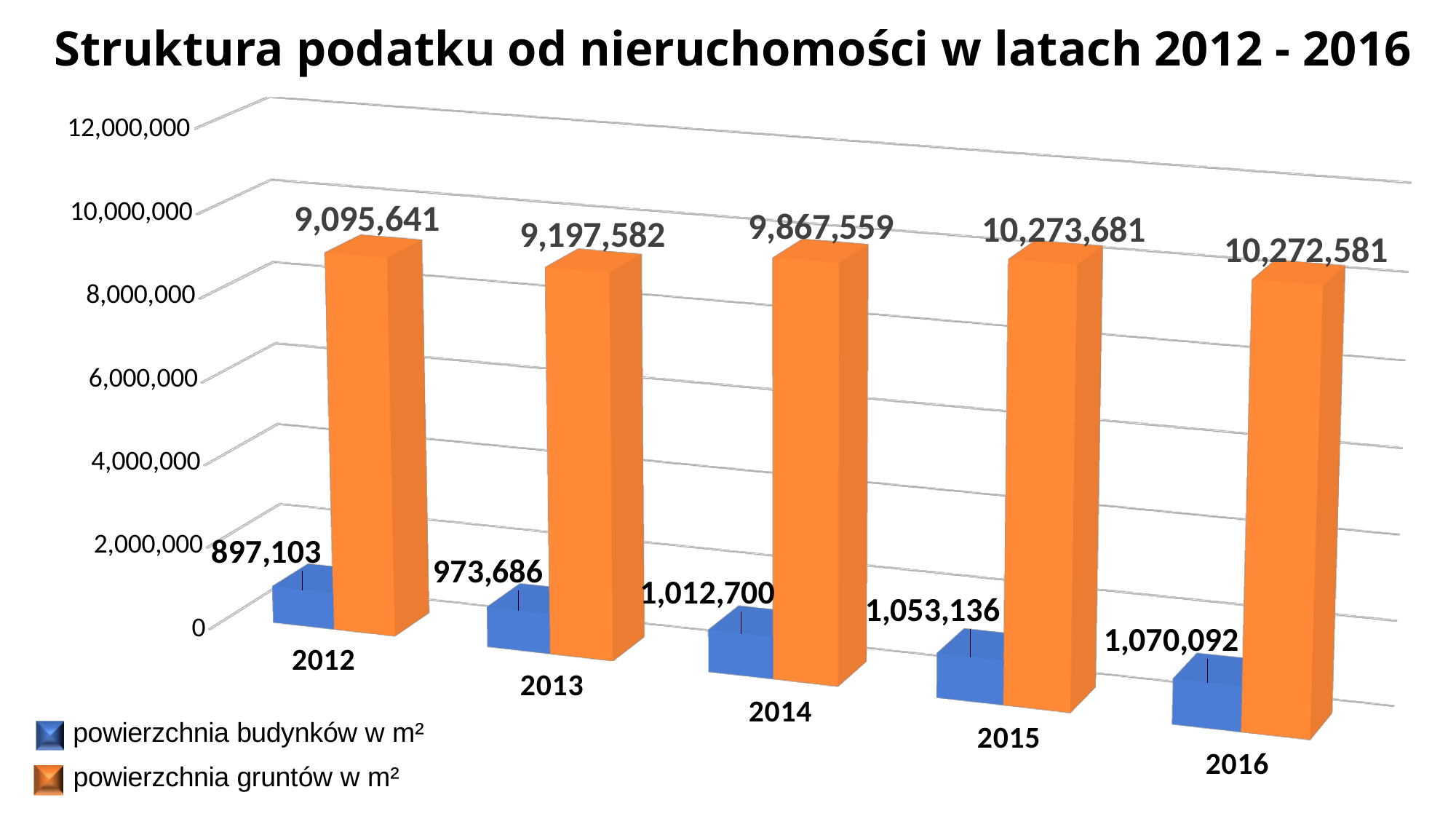
How many years are shown on the x axis? 5 In which year is powierzchnia budynków w m² the highest? 2016 Which is larger: powierzchnia gruntów w m² in 2013 or in 2014? 2014 What is the value of powierzchnia budynków w m² for 2016? 1,070,092 What is the difference between powierzchnia budynków w m² in 2016 and in 2012? 172,989 In which year is powierzchnia gruntów w m² the lowest? 2012 What is the value of powierzchnia gruntów w m² for 2014? 9,867,559 Does powierzchnia budynków w m² rise or fall from 2012 to 2016? rise How many series does the legend list? 2 Is the value of powierzchnia gruntów w m² for 2012 greater or less than 8,000,000? greater What is the difference between powierzchnia gruntów w m² in 2014 and in 2013? 669,977 What is the value of powierzchnia budynków w m² for 2012? 897,103